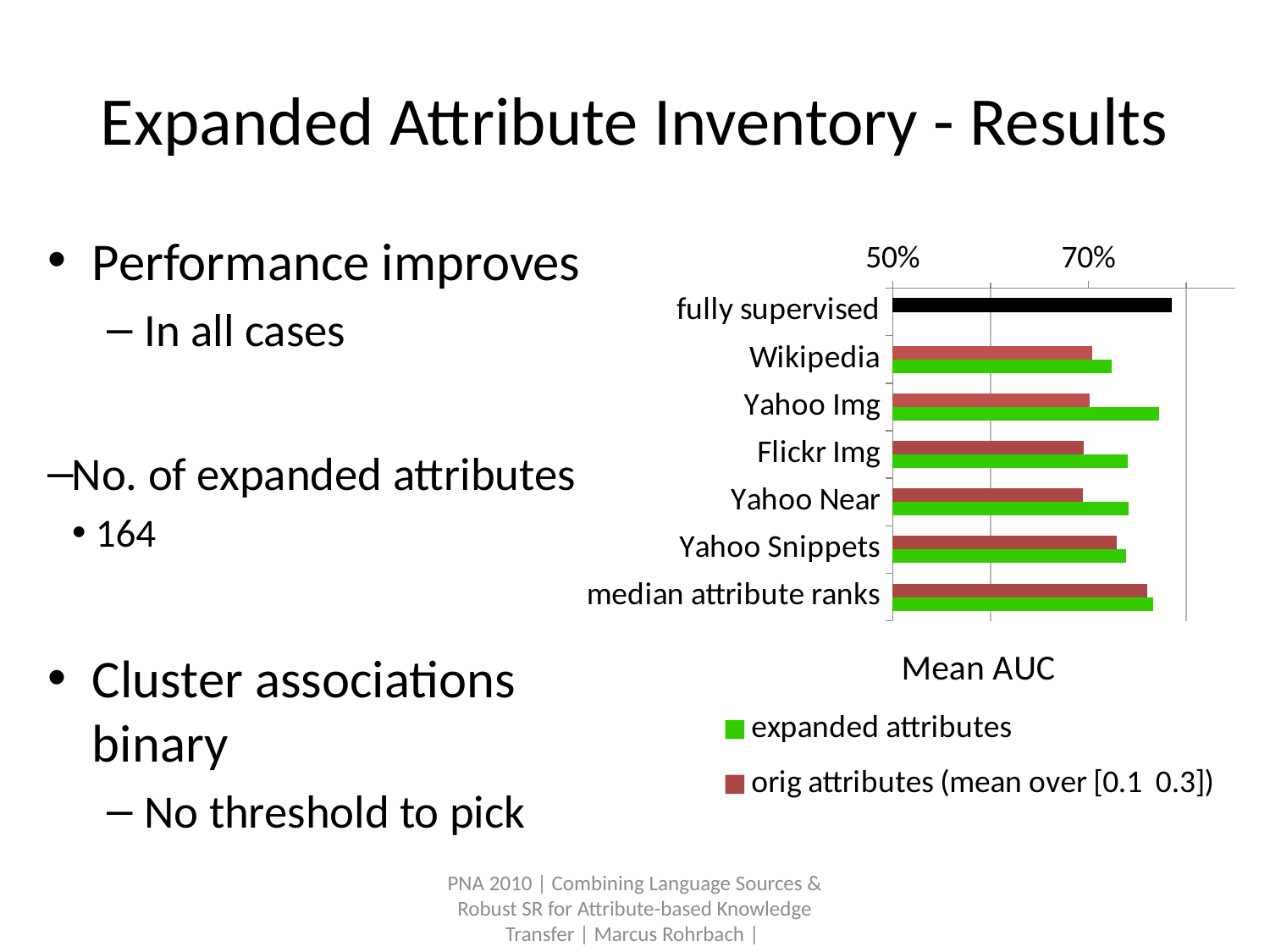
Which colour represents the 'expanded attributes' series in the chart? green How many series does the chart legend list? 2 Is the 'orig attributes' value for median attribute ranks greater or less than 70%? greater What is the axis title shown below the chart? Mean AUC For Flickr Img, which series has the larger value: expanded attributes or orig attributes? expanded attributes Is the 'orig attributes' value for Yahoo Near greater or less than 50%? greater Is the value for 'fully supervised' greater or less than 70%? greater For Yahoo Img, which series has the larger value: expanded attributes or orig attributes? expanded attributes What kind of chart is shown on the slide? bar chart How many categories are listed on the vertical axis of the chart? 7 Which is larger: the value for 'fully supervised' or the 'orig attributes' value for Wikipedia? fully supervised